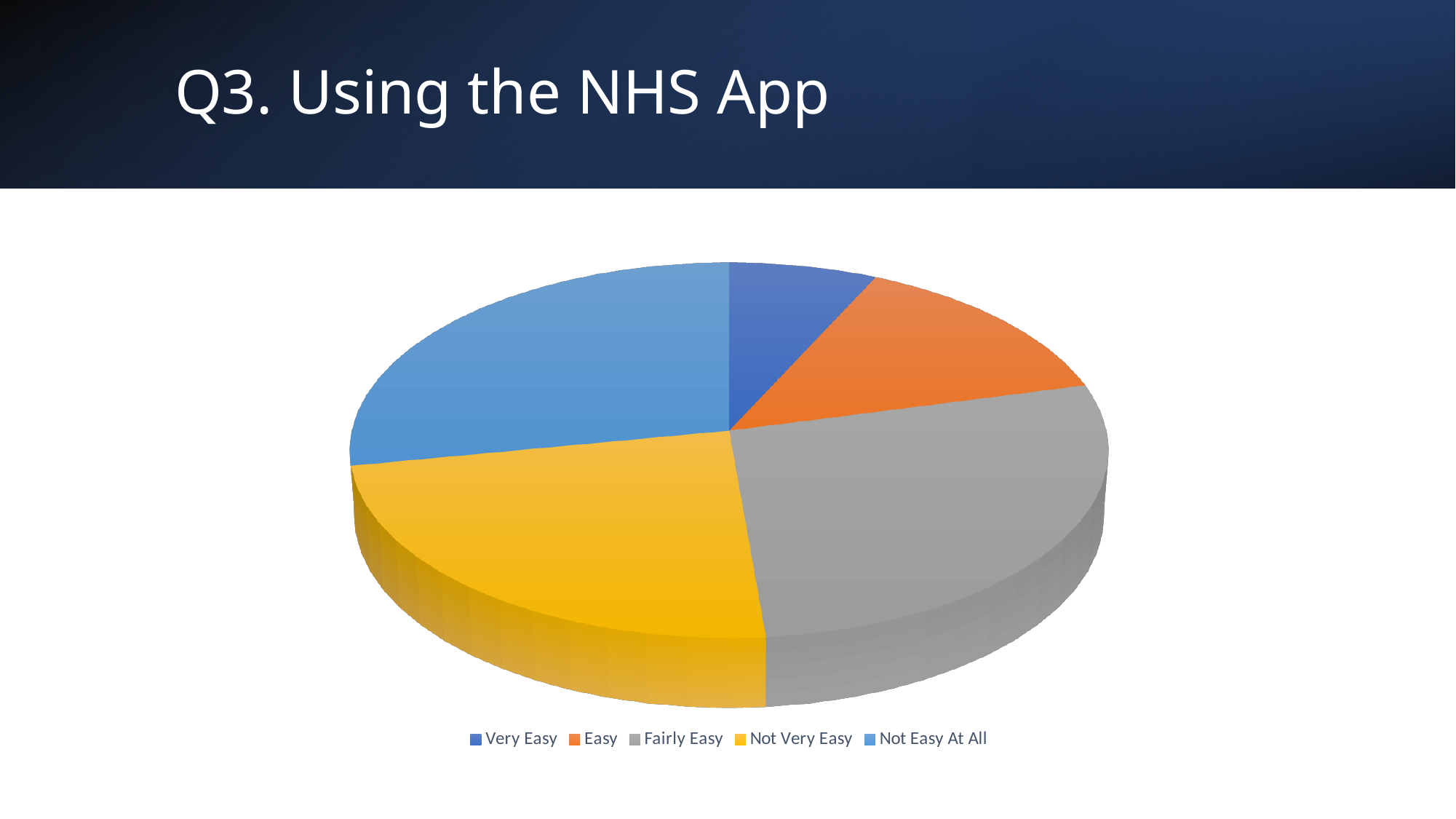
What is the title of the slide containing the pie chart? Q3. Using the NHS App Which category has the smallest slice of the pie chart? Very Easy Which slice is larger, Very Easy or Easy? Easy How many categories (slices) does the pie chart have? 5 What kind of chart is shown on the slide? Pie chart What colour is the Not Very Easy slice in the pie chart? Yellow Which slice is larger, Very Easy or Not Easy At All? Not Easy At All Which slice is larger, Easy or Fairly Easy? Fairly Easy How many entries does the legend list? 5